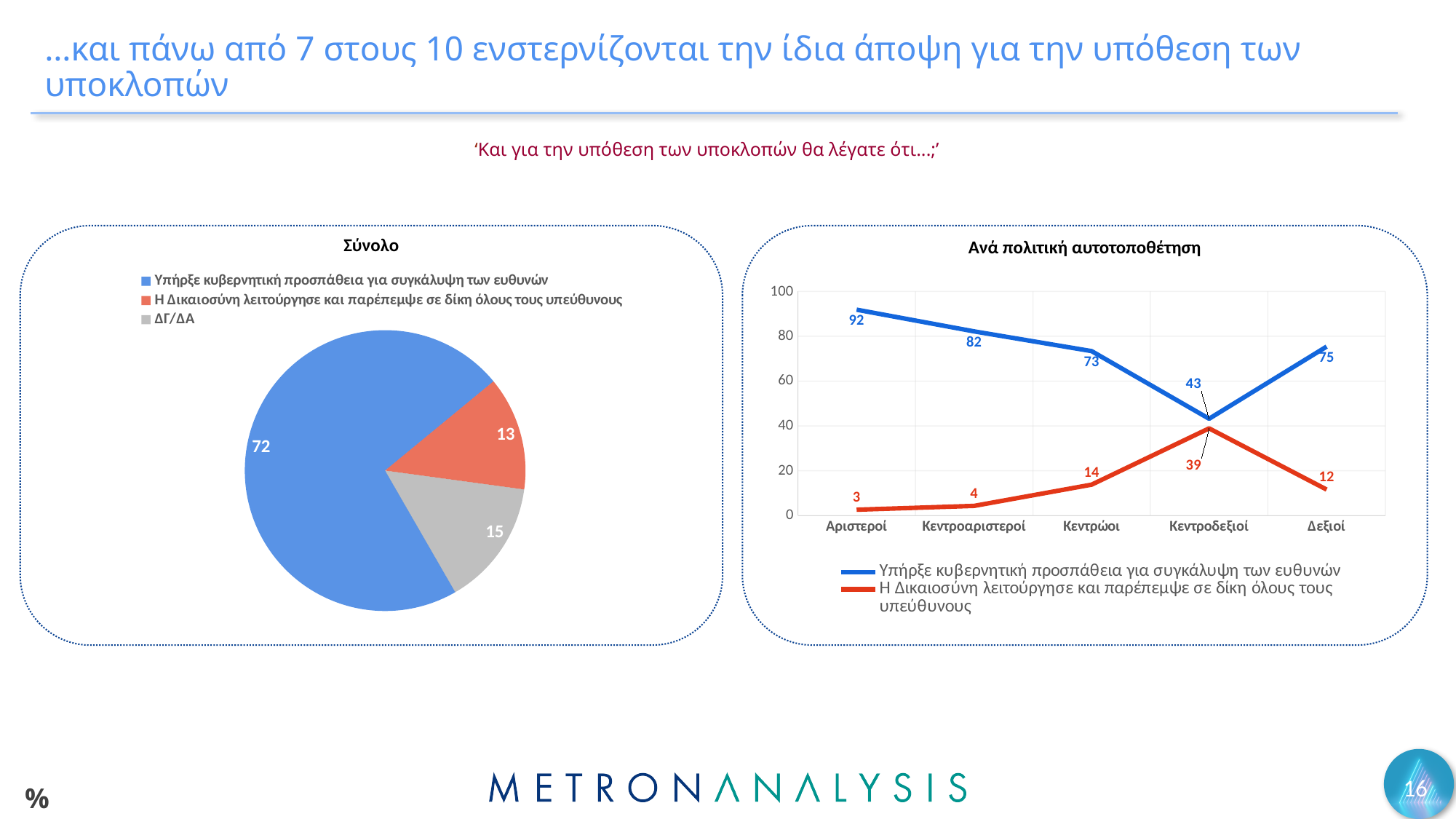
What kind of chart is the 'Σύνολο' chart? Pie chart What kind of chart is the 'Ανά πολιτική αυτοτοποθέτηση' chart? Line chart How many series does the legend of the 'Ανά πολιτική αυτοτοποθέτηση' chart list? 2 In the 'Ανά πολιτική αυτοτοποθέτηση' chart, for which category is the 'Η Δικαιοσύνη λειτούργησε και παρέπεμψε σε δίκη όλους τους υπεύθυνους' series highest? Κεντροδεξιοί In the 'Ανά πολιτική αυτοτοποθέτηση' chart, for which category is the 'Υπήρξε κυβερνητική προσπάθεια για συγκάλυψη των ευθυνών' series highest? Αριστεροί In the 'Σύνολο' chart, which category has the smallest slice? Η Δικαιοσύνη λειτούργησε και παρέπεμψε σε δίκη όλους τους υπεύθυνους In the 'Ανά πολιτική αυτοτοποθέτηση' chart, what is the value of 'Η Δικαιοσύνη λειτούργησε και παρέπεμψε σε δίκη όλους τους υπεύθυνους' for 'Κεντρώοι'? 14 In the 'Ανά πολιτική αυτοτοποθέτηση' chart, what is the difference between the two series for 'Δεξιοί'? 63 In the 'Σύνολο' chart, what is the value for 'Υπήρξε κυβερνητική προσπάθεια για συγκάλυψη των ευθυνών'? 72 In the 'Σύνολο' chart, what is the value for 'ΔΓ/ΔΑ'? 15 In the 'Ανά πολιτική αυτοτοποθέτηση' chart, what is the value of 'Υπήρξε κυβερνητική προσπάθεια για συγκάλυψη των ευθυνών' for 'Κεντροδεξιοί'? 43 In the 'Ανά πολιτική αυτοτοποθέτηση' chart, how many categories are shown on the x axis? 5